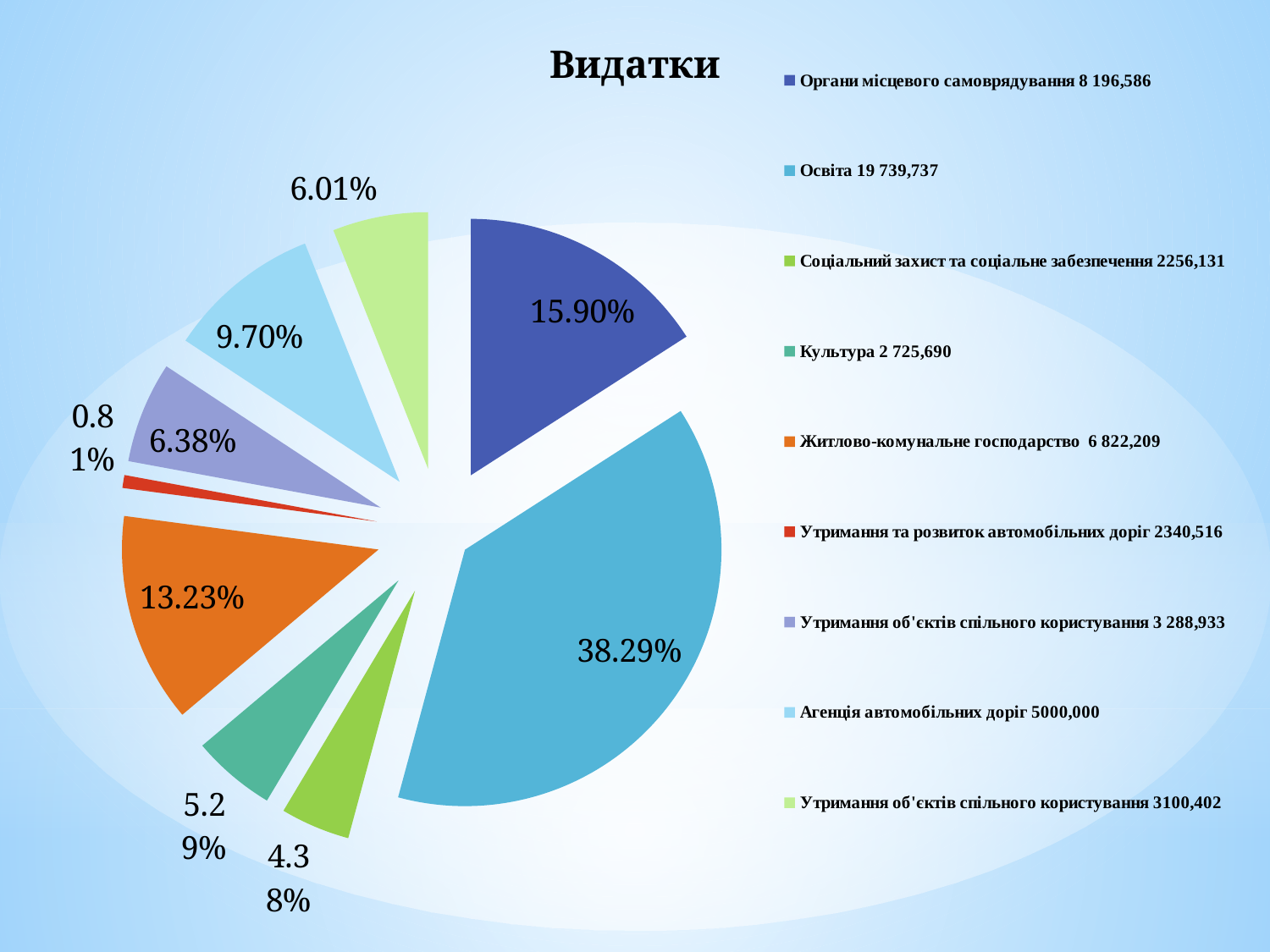
Which slice is larger: Культура or Соціальний захист та соціальне забезпечення? Культура By how many percentage points does the Освіта share exceed the Органи місцевого самоврядування share? 22.39 Which category has the smallest slice of the pie? Утримання та розвиток автомобільних доріг What kind of chart is shown on the slide? pie chart What percentage is shown for Агенція автомобільних доріг? 9.70% How many slices does the pie chart have? 9 What percentage share does the Освіта slice have? 38.29% What is the title of the chart? Видатки What amount is listed in the legend next to Освіта? 19 739,737 Which category has the largest slice of the pie? Освіта What percentage is shown for Органи місцевого самоврядування? 15.90% What percentage is shown for Житлово-комунальне господарство? 13.23%